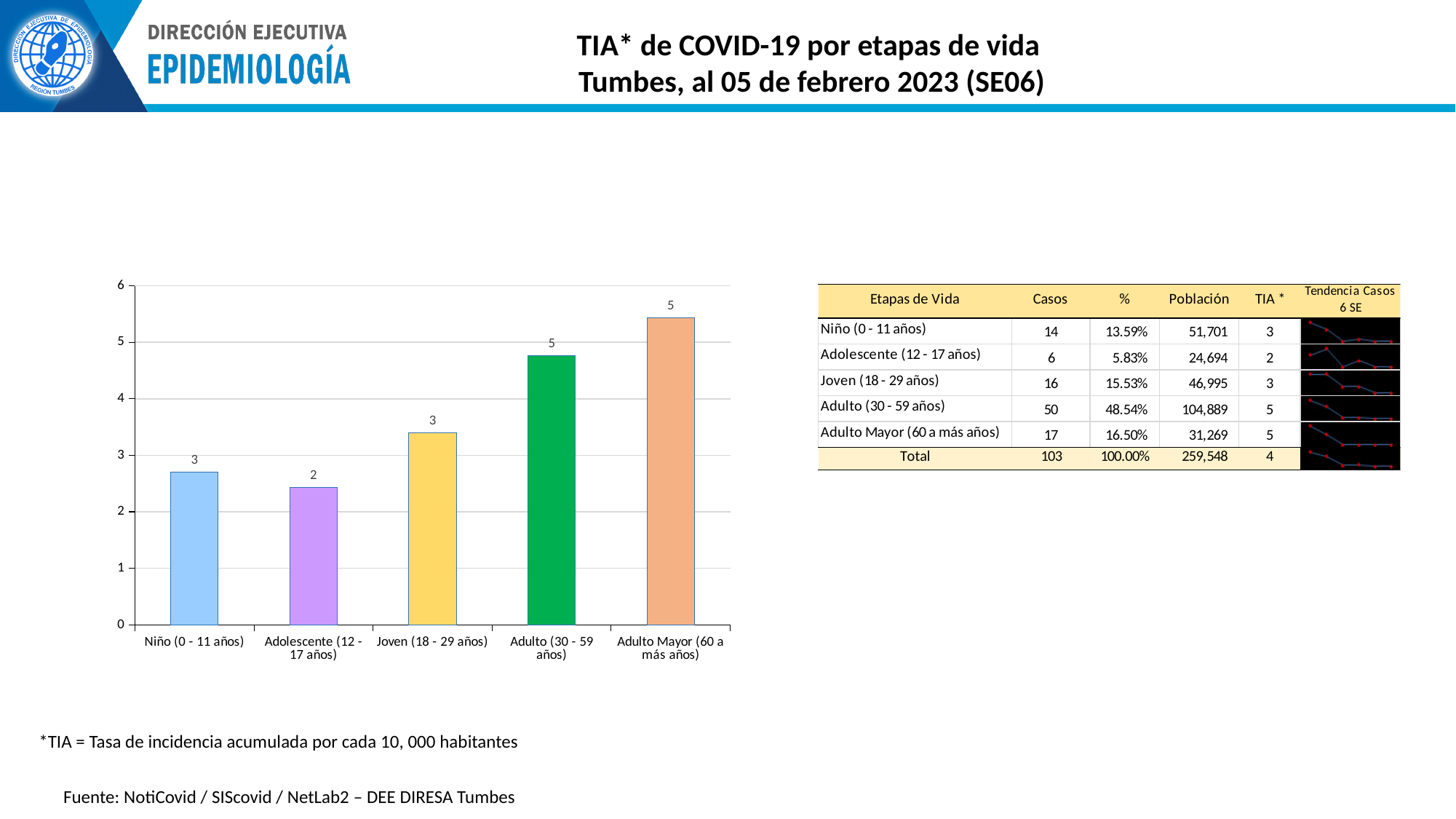
What is the data label shown for Adulto (30 - 59 años)? 5 Which is larger, the bar for Adulto (30 - 59 años) or the bar for Joven (18 - 29 años)? Adulto (30 - 59 años) Which age group has the highest bar in the chart? Adulto Mayor (60 a más años) What is the data label shown for Niño (0 - 11 años)? 3 What kind of chart is shown on the slide? bar chart What is the data label shown for Adolescente (12 - 17 años)? 2 Which age group has the lowest bar in the chart? Adolescente (12 - 17 años) How many age groups are plotted in the chart? 5 What colour is the bar for Adulto (30 - 59 años)? green Using the data labels, what is the difference between the value for Adulto Mayor (60 a más años) and the value for Adolescente (12 - 17 años)? 3